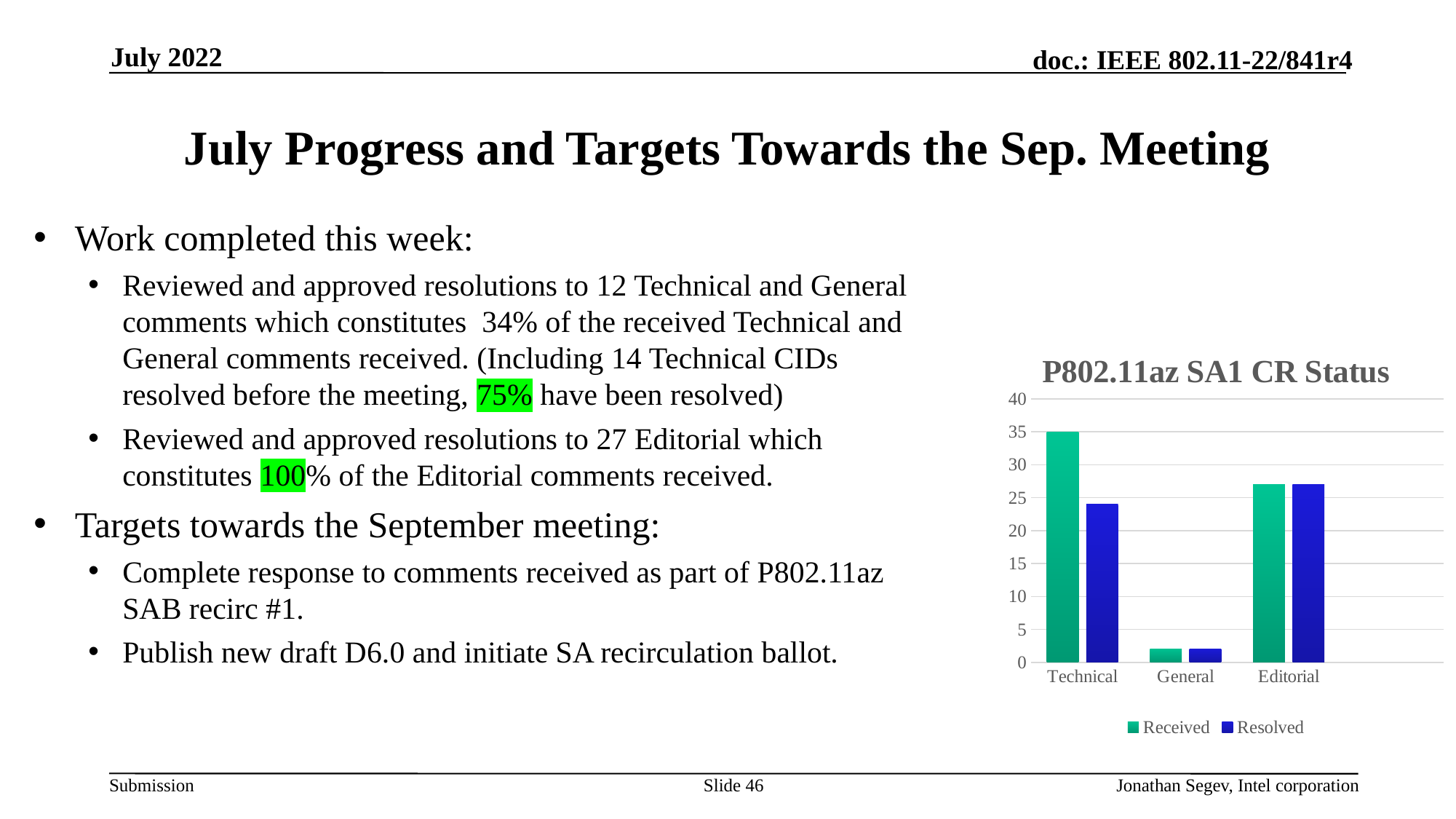
How many series does the chart's legend list? 2 Is the Received value for General greater or less than 5? less Is the Resolved value for Technical greater or less than 20? greater What kind of chart is shown on the slide? bar chart Which category has the lowest Received value? General Is the Resolved value for Editorial greater or less than 25? greater For the Technical category, which is larger: Received or Resolved? Received How many categories are shown on the x axis of the chart? 3 What is the title of the chart? P802.11az SA1 CR Status Which category has the highest Received value? Technical Which series is shown in blue in the chart? Resolved